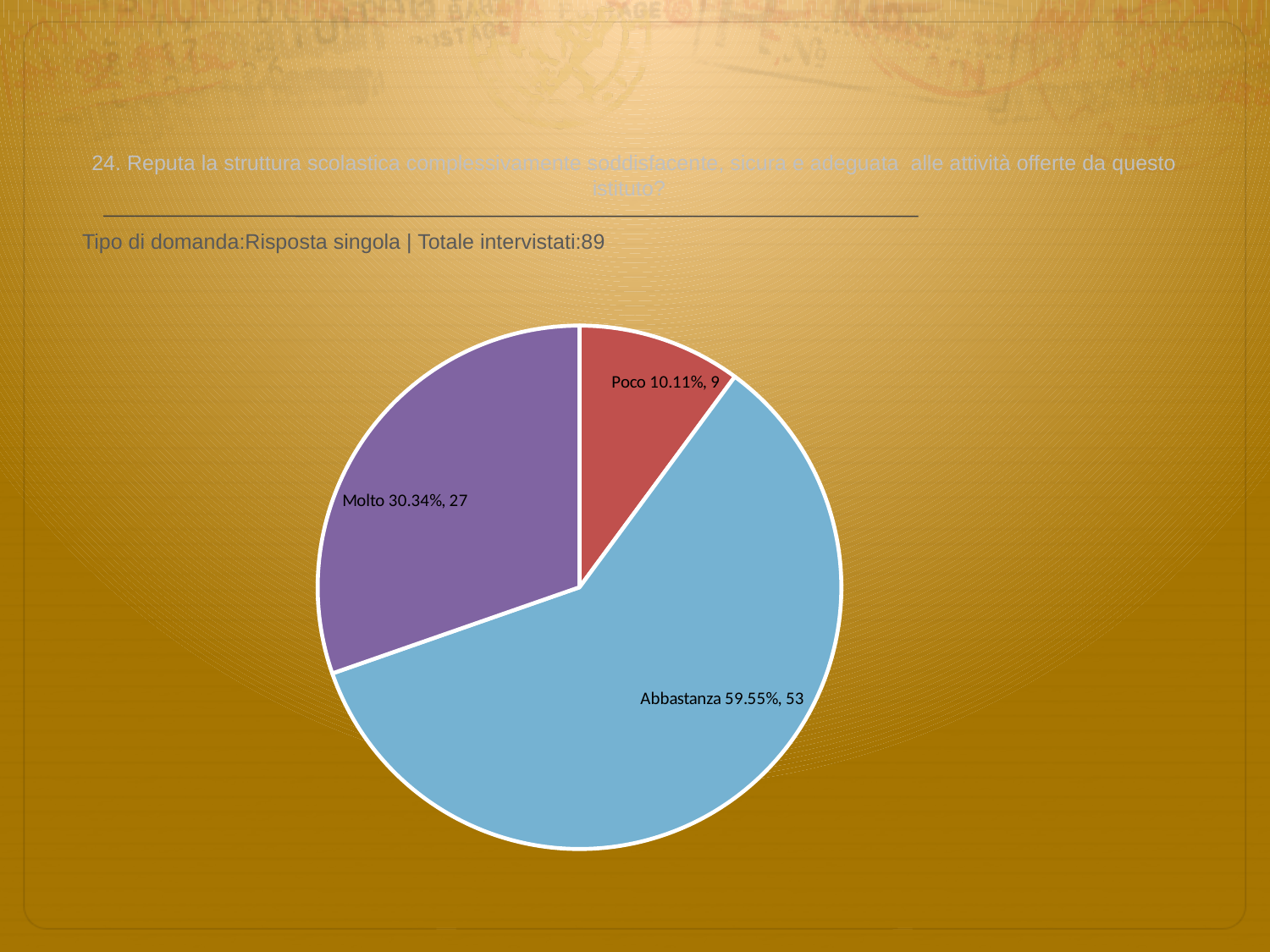
What percentage share does the Molto slice have? 30.34% Which slice is larger, Molto or Poco? Molto Which category has the largest slice of the pie? Abbastanza How many respondents answered Abbastanza? 53 What is the difference in respondent count between Abbastanza and Molto? 26 How many slices does the pie chart have? 3 What percentage share does the Abbastanza slice have? 59.55% Which category has the smallest slice of the pie? Poco What percentage share does the Poco slice have? 10.11% How many respondents answered Poco? 9 What kind of chart is shown on the slide? pie chart How many respondents answered Molto? 27